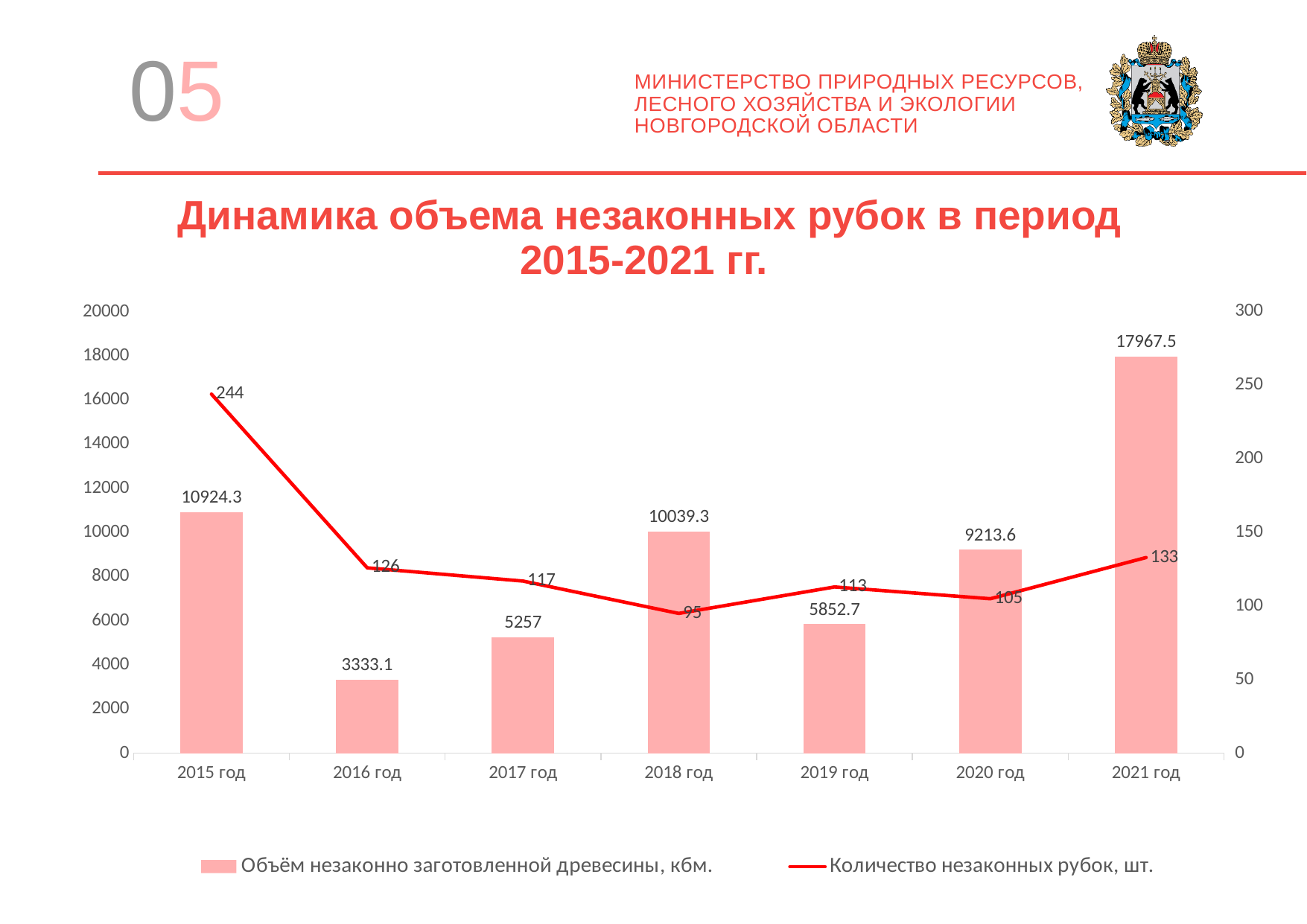
What is the volume of illegally harvested timber (Объём незаконно заготовленной древесины, кбм.) for 2021 год? 17967.5 What is the title of the chart on the slide? Динамика объема незаконных рубок в период 2015-2021 гг. What is the volume of illegally harvested timber for 2016 год? 3333.1 What is the difference in the number of illegal fellings between 2015 год and 2016 год? 118 Which year has the highest volume of illegally harvested timber? 2021 год What is the number of illegal fellings for 2018 год? 95 How many series does the chart legend list? 2 Which year has the lowest number of illegal fellings? 2018 год What is the number of illegal fellings (Количество незаконных рубок, шт.) for 2015 год? 244 How many years are shown on the x axis of the chart? 7 Which is larger: the volume of illegally harvested timber in 2018 год or in 2020 год? 2018 год Which year has the lowest volume of illegally harvested timber? 2016 год